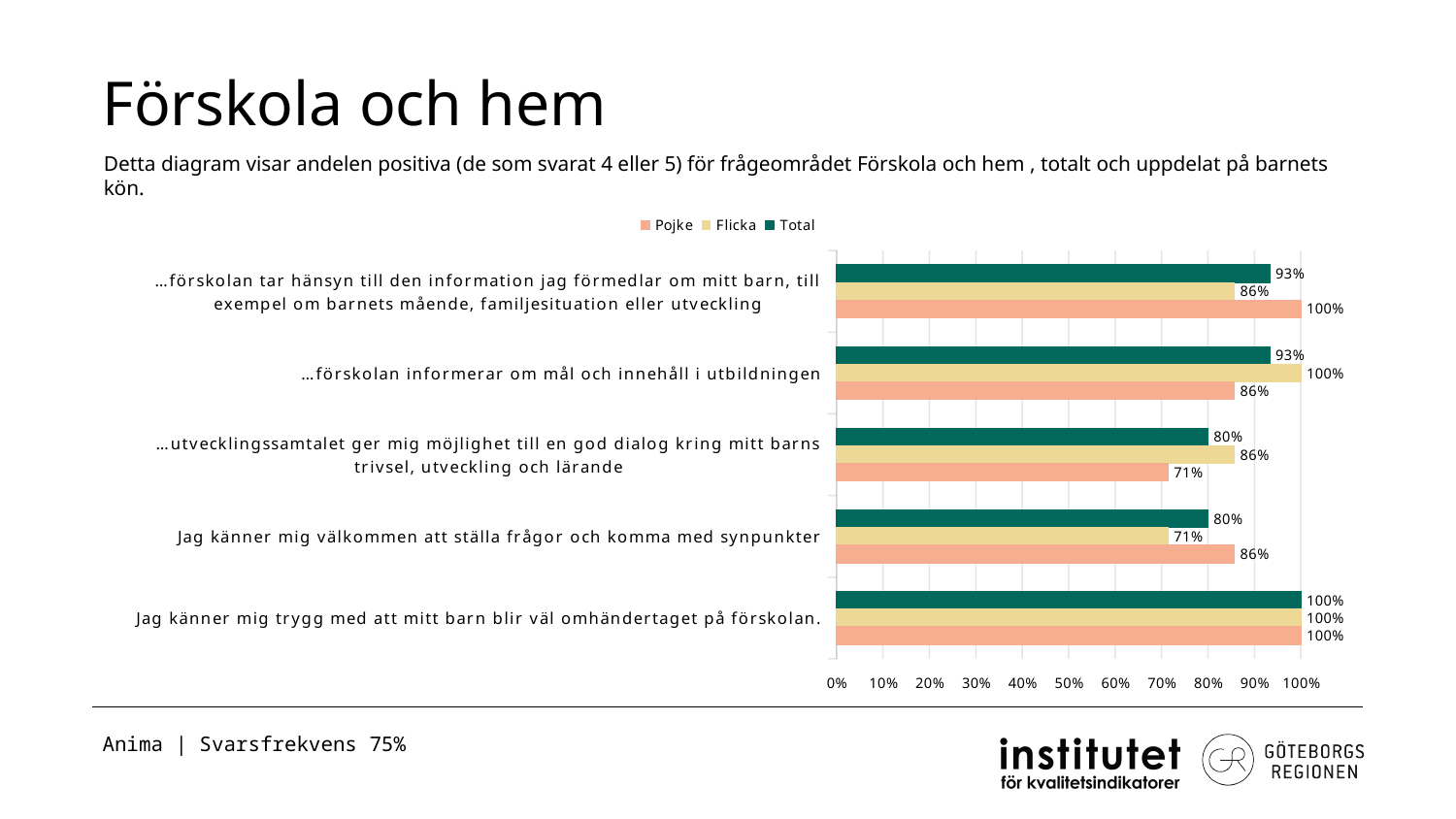
What is the difference between the Pojke and Flicka values for "…förskolan tar hänsyn till den information jag förmedlar om mitt barn, till exempel om barnets mående, familjesituation eller utveckling"? 14% What is the Pojke value for "…utvecklingssamtalet ger mig möjlighet till en god dialog kring mitt barns trivsel, utveckling och lärande"? 71% How many categories are shown on the y axis of the chart? 5 How many series does the legend list? 3 What is the Flicka value for "…förskolan informerar om mål och innehåll i utbildningen"? 100% What is the Total value for "…utvecklingssamtalet ger mig möjlighet till en god dialog kring mitt barns trivsel, utveckling och lärande"? 80% Which category has the highest Total value? Jag känner mig trygg med att mitt barn blir väl omhändertaget på förskolan. For "…förskolan informerar om mål och innehåll i utbildningen", which is larger, the Pojke value or the Flicka value? Flicka Which category has the lowest Flicka value? Jag känner mig välkommen att ställa frågor och komma med synpunkter What is the Pojke value for "Jag känner mig välkommen att ställa frågor och komma med synpunkter"? 86% What kind of chart is shown on the slide? Bar chart Which series is shown in dark green in the legend? Total